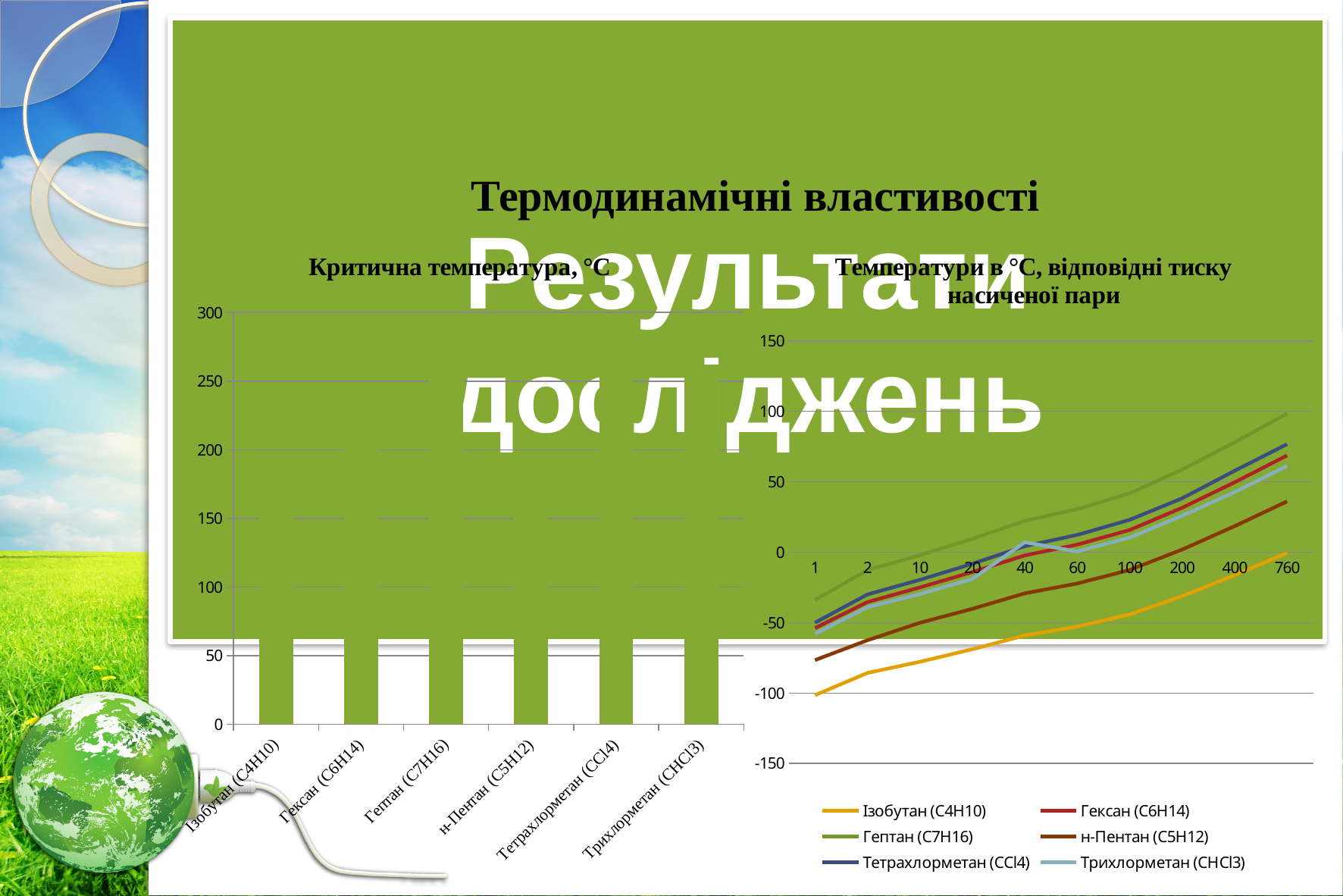
In the right chart, is the value for н-Пентан (C5H12) at x = 1 greater or less than -50? less In the right chart, do the values of Ізобутан (C4H10) rise or fall along the x axis? rise In the right chart, which is larger at x = 760: Гептан (C7H16) or н-Пентан (C5H12)? Гептан (C7H16) How many categories does the left chart "Критична температура, °C" show? 6 In the right chart, which series has the lowest value at x = 1? Ізобутан (C4H10) In the right chart, is the value for Гептан (C7H16) at x = 760 greater or less than 50? greater How many series does the legend of the right chart list? 6 How many x-axis points does the right chart have? 10 What kind of chart is the left chart titled "Критична температура, °C"? bar chart What kind of chart is the right chart titled "Температури в °C, відповідні тиску насиченої пари"? line chart In the right chart, is the value for Ізобутан (C4H10) at x = 760 greater or less than 50? less In the right chart, which series has the highest value at x = 760? Гептан (C7H16)